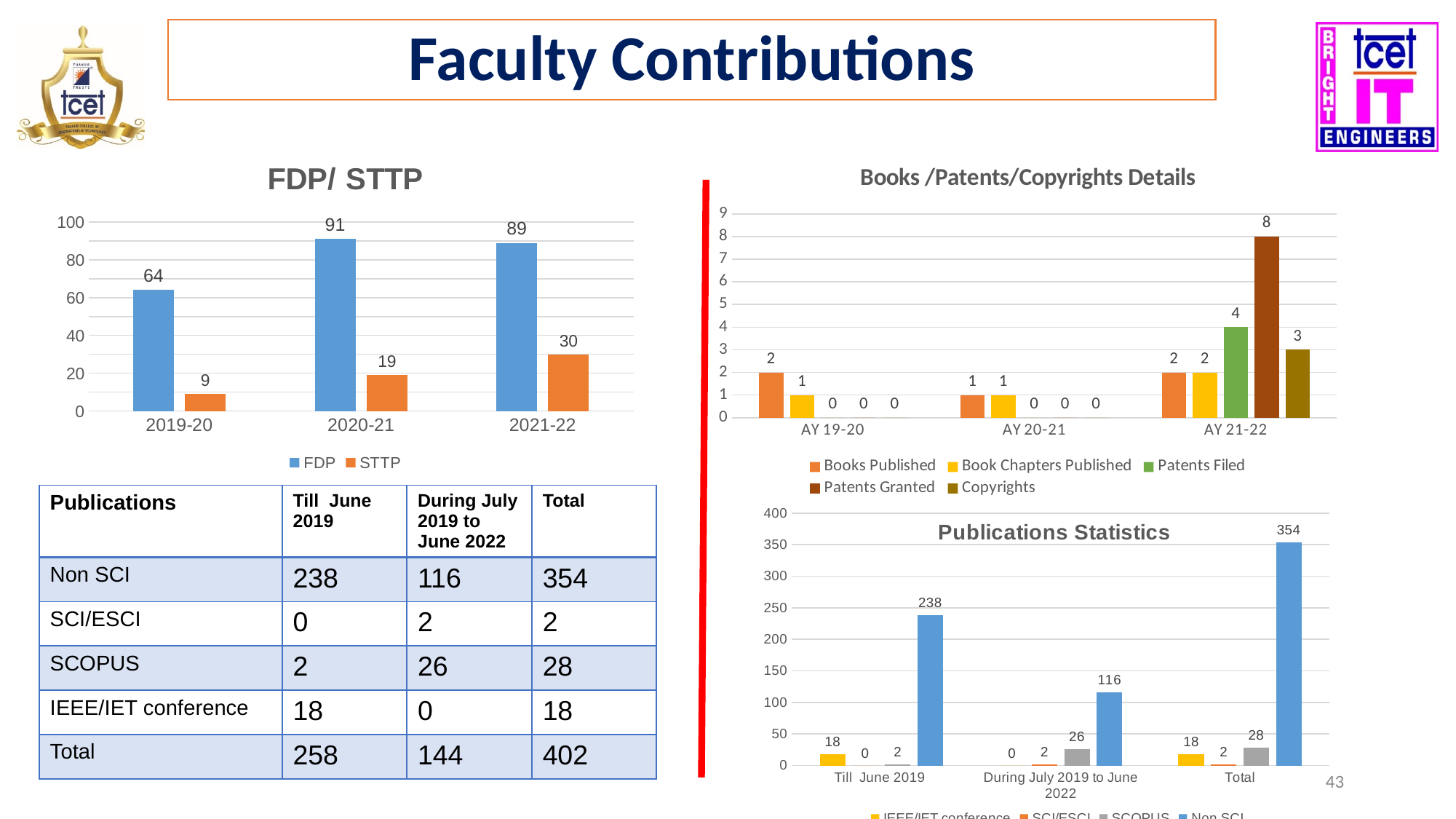
In the Books /Patents/Copyrights Details chart, what is the Patents Granted value for AY 21-22? 8 In the FDP/ STTP chart, do the STTP values rise or fall from 2019-20 to 2021-22? rise In the Books /Patents/Copyrights Details chart, which series has the highest value in AY 21-22? Patents Granted In the FDP/ STTP chart, what is the STTP value for 2021-22? 30 In the Publications Statistics chart, what is the Non SCI value for Total? 354 In the FDP/ STTP chart, which year has the lowest STTP value? 2019-20 What kind of chart is the Publications Statistics chart? bar chart In the Books /Patents/Copyrights Details chart, what is the Copyrights value for AY 21-22? 3 In the FDP/ STTP chart, what is the FDP value for 2020-21? 91 In the FDP/ STTP chart, how many series does the legend list? 2 In the Books /Patents/Copyrights Details chart, how many series does the legend list? 5 In the FDP/ STTP chart, what is the difference between the FDP and STTP values for 2019-20? 55